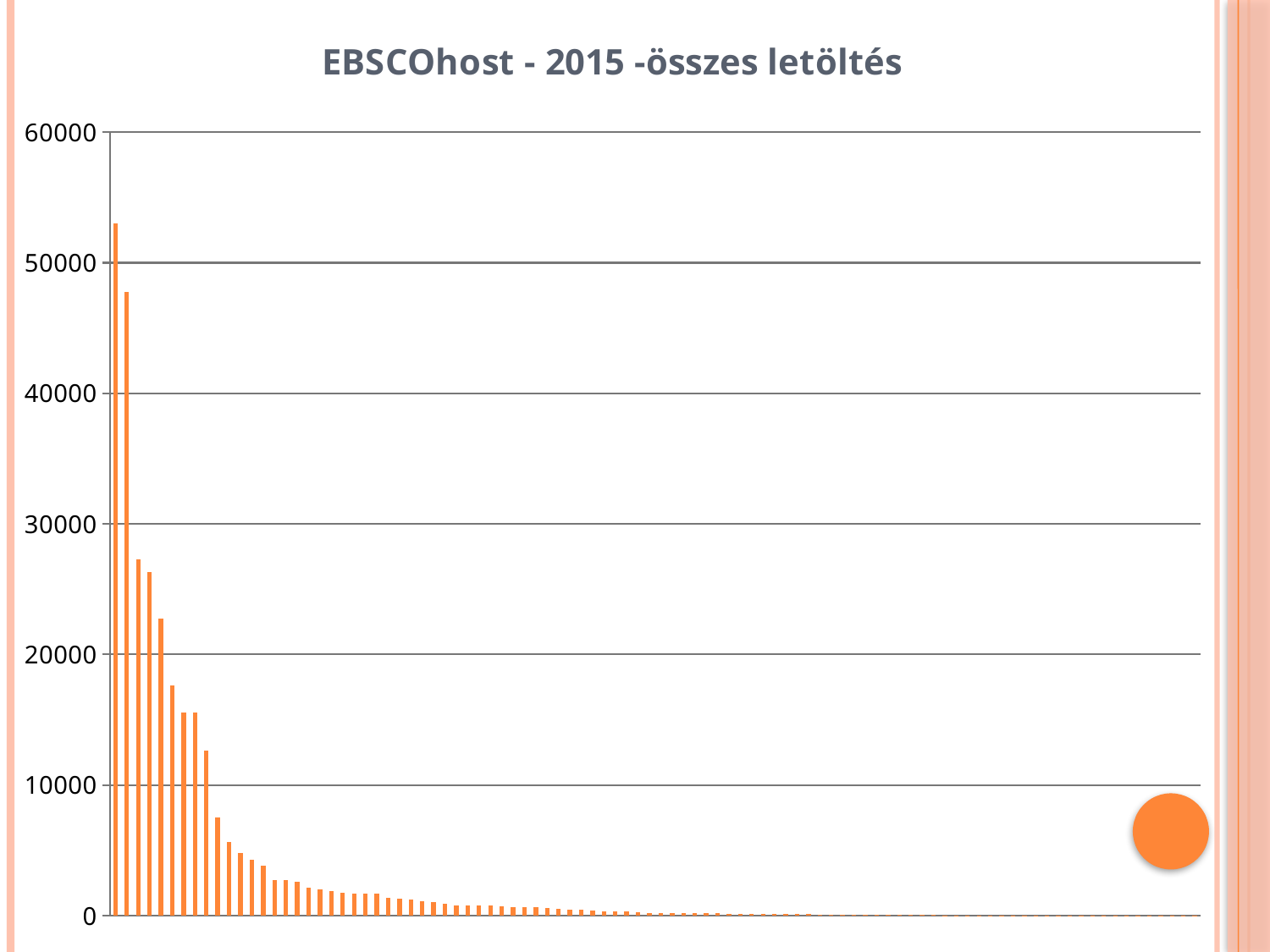
Is the value of the third bar from the left greater or less than 20000? greater Do the bar values rise or fall from left to right along the x axis? fall Is the value of the third bar from the left greater or less than 30000? less What is the title of the chart? EBSCOhost - 2015 -összes letöltés Is the value of the second bar from the left greater or less than 40000? greater Which bar is the highest: the leftmost bar or the second bar from the left? the leftmost bar What is the highest value shown on the vertical axis? 60000 What kind of chart is shown on the slide? bar chart